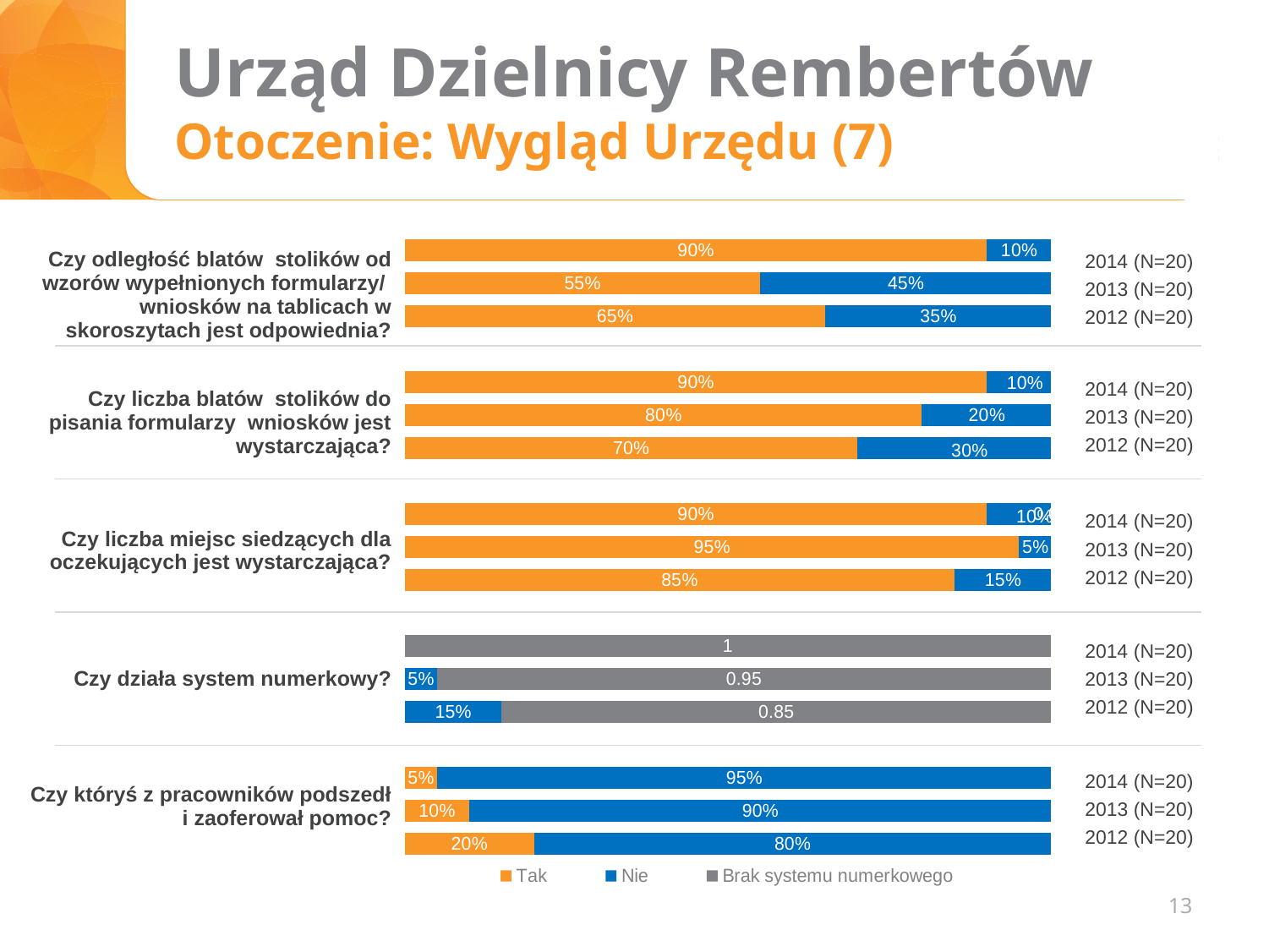
In the chart for "Czy działa system numerkowy?", what is the Brak systemu numerkowego value for 2012 (N=20)? 0.85 In the chart for "Czy działa system numerkowy?", what is the Nie value for 2013 (N=20)? 5% In the chart for "Czy któryś z pracowników podszedł i zaoferował pomoc?", which is larger for 2012 (N=20): the Tak value or the Nie value? Nie In the chart for "Czy liczba blatów stolików do pisania formularzy wniosków jest wystarczająca?", what is the Nie value for 2012 (N=20)? 30% How many series does the legend at the bottom of the slide list? 3 In the chart for "Czy odległość blatów stolików od wzorów wypełnionych formularzy/wniosków na tablicach w skoroszytach jest odpowiednia?", what is the Tak value for 2013 (N=20)? 55% In the chart for "Czy liczba blatów stolików do pisania formularzy wniosków jest wystarczająca?", what is the difference between the Tak values for 2014 (N=20) and 2012 (N=20)? 20% In the chart for "Czy liczba miejsc siedzących dla oczekujących jest wystarczająca?", what is the Tak value for 2013 (N=20)? 95% In the chart for "Czy odległość blatów stolików od wzorów wypełnionych formularzy/wniosków na tablicach w skoroszytach jest odpowiednia?", which year has the highest Tak value? 2014 (N=20) In the chart for "Czy liczba miejsc siedzących dla oczekujących jest wystarczająca?", which year has the lowest Tak value? 2012 (N=20) What kind of chart is used for "Czy któryś z pracowników podszedł i zaoferował pomoc?"? stacked bar chart In the chart for "Czy liczba blatów stolików do pisania formularzy wniosków jest wystarczająca?", does the Tak value rise or fall from 2012 to 2014? rise